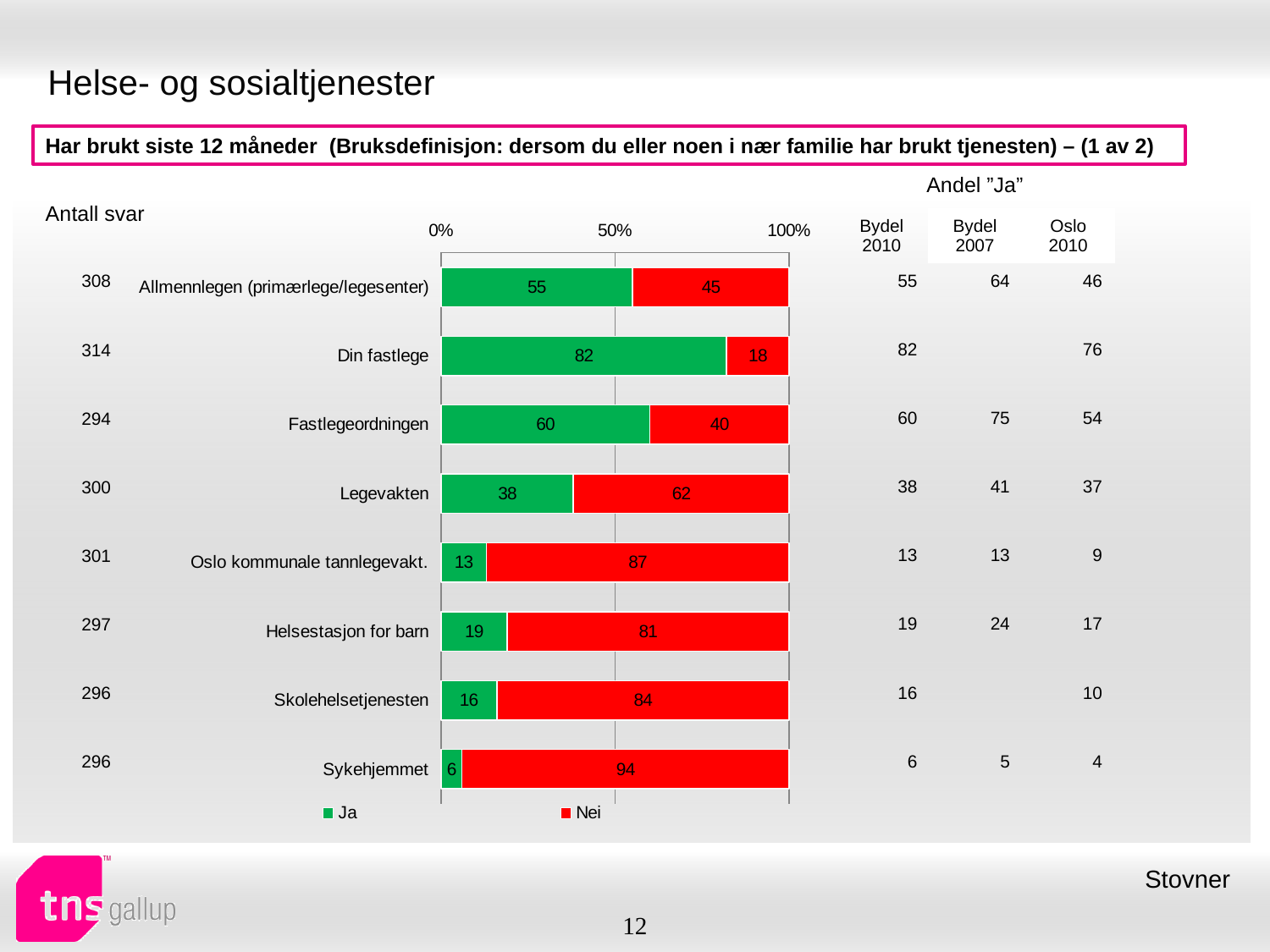
What is the total of the stacked bar for Allmennlegen (primærlege/legesenter)? 100 Which colour represents the "Nei" series in the chart? Red Which category has the highest "Ja" value? Din fastlege What is the "Nei" value for Legevakten? 62 What is the "Ja" value for Helsestasjon for barn? 19 How many categories are shown in the bar chart? 8 How many series does the legend list? 2 What is the "Ja" value for Din fastlege? 82 What is the difference between the "Ja" values for Fastlegeordningen and Legevakten? 22 Which category has the lowest "Ja" value? Sykehjemmet What kind of chart is shown on the slide? Stacked bar chart Which is larger, the "Nei" value for Oslo kommunale tannlegevakt. or the "Nei" value for Skolehelsetjenesten? Oslo kommunale tannlegevakt.